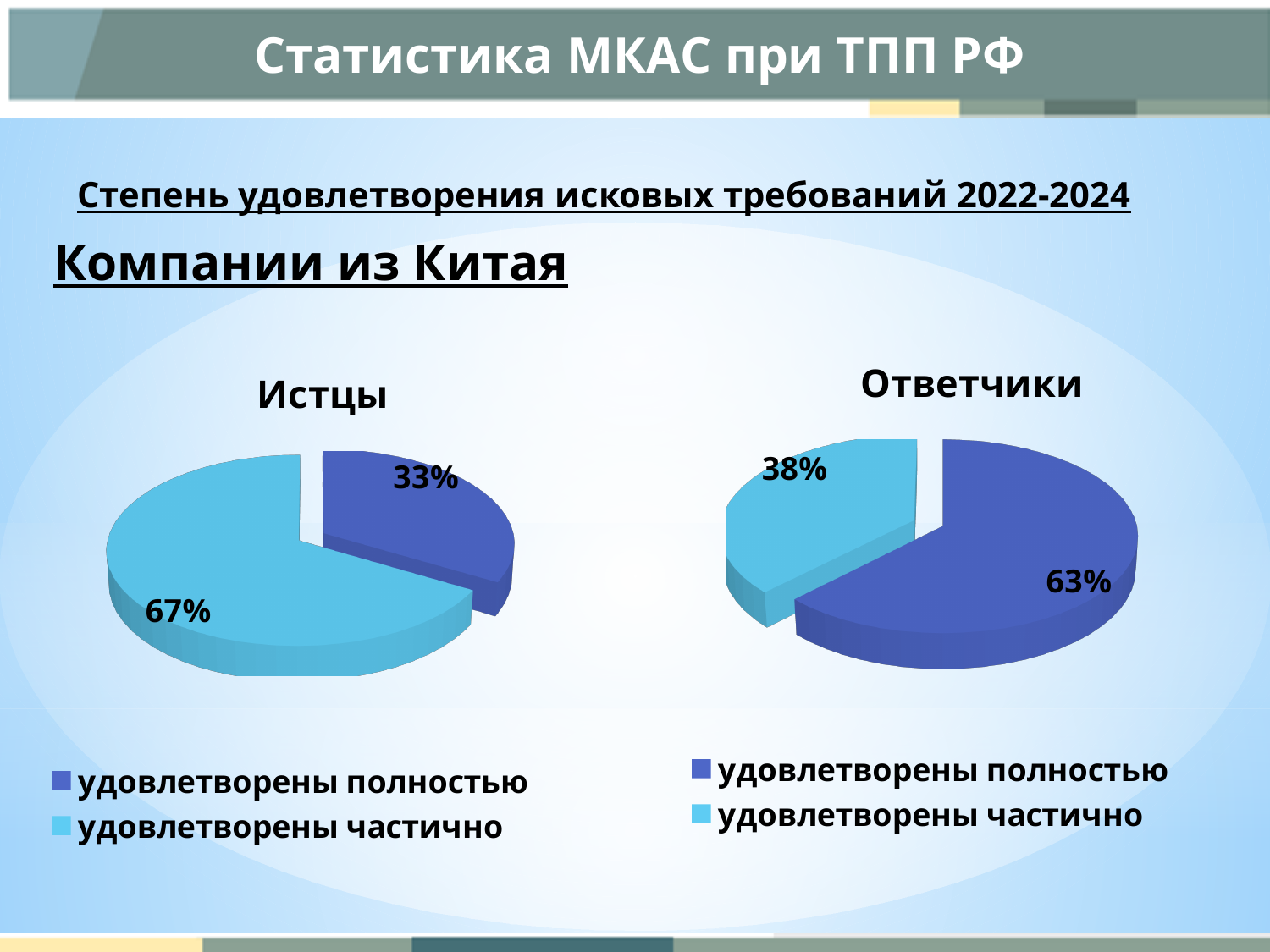
How many entries does the legend of the "Истцы" chart list? 2 What type of chart is used for "Истцы" and "Ответчики"? Pie chart In the "Ответчики" pie chart, what is the difference between the "удовлетворены полностью" and "удовлетворены частично" shares? 25 percentage points How many slices does the "Ответчики" pie chart have? 2 Which is larger: the "удовлетворены полностью" share in the "Истцы" chart or in the "Ответчики" chart? Ответчики In the "Ответчики" pie chart, what share is labelled for "удовлетворены полностью"? 63% In the "Ответчики" pie chart, which category has the smallest slice? удовлетворены частично In the "Ответчики" pie chart, what share is labelled for "удовлетворены частично"? 38% In the "Истцы" pie chart, what share is labelled for "удовлетворены полностью"? 33% In the "Истцы" pie chart, what is the difference between the "удовлетворены частично" and "удовлетворены полностью" shares? 34 percentage points In the "Истцы" pie chart, which category has the largest slice? удовлетворены частично In the "Истцы" pie chart, what share is labelled for "удовлетворены частично"? 67%